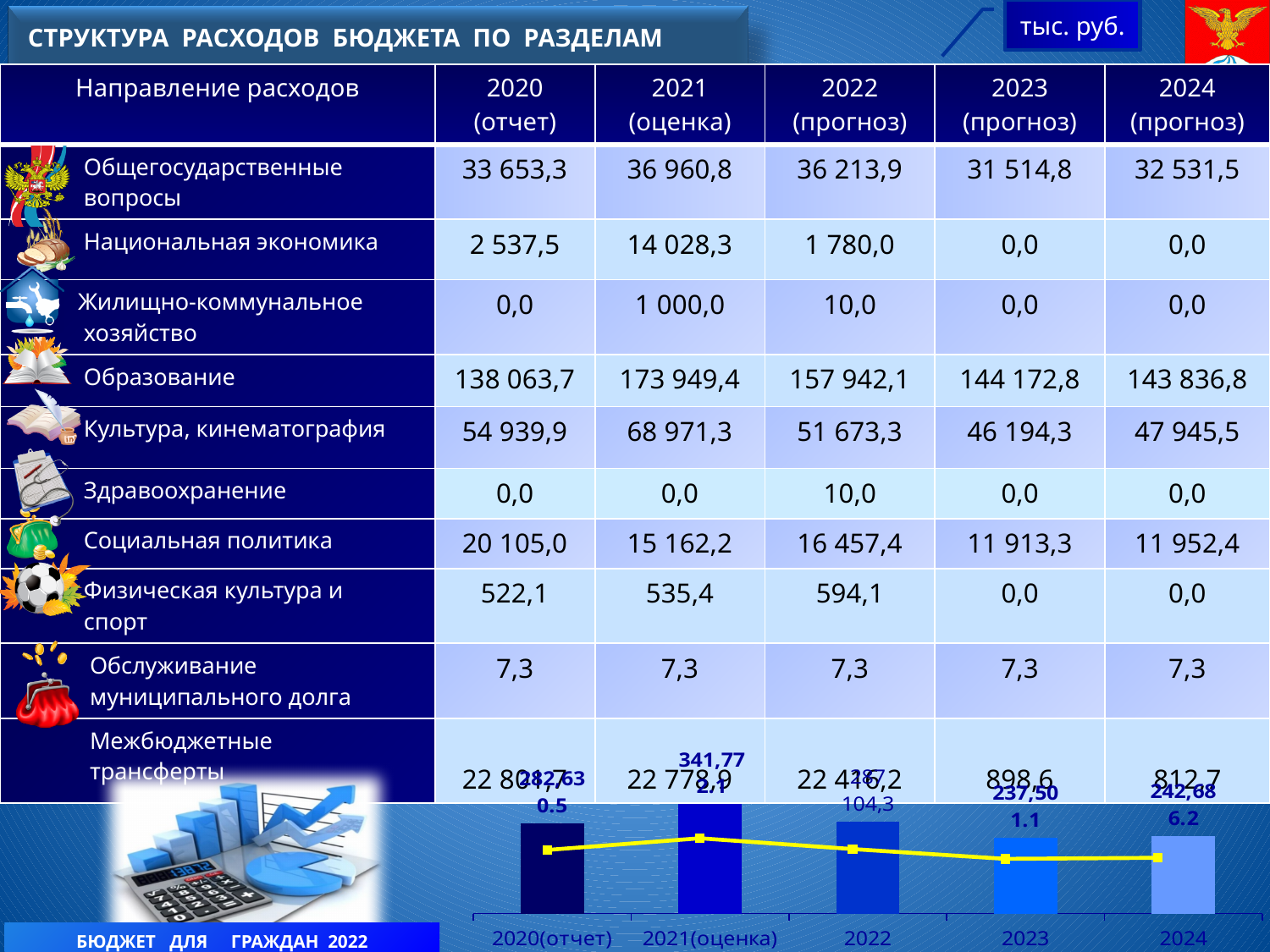
In the chart at the bottom of the slide, what is the bar value labelled for 2021(оценка)? 341,772.1 How many categories (years) are shown on the x axis of the chart at the bottom of the slide? 5 In the chart at the bottom of the slide, which year has the shortest bar? 2023 In the chart at the bottom of the slide, what is the bar value labelled for 2024? 242,686.2 In the chart at the bottom of the slide, which bar is larger: 2023 or 2024? 2024 What kind of chart is shown at the bottom of the slide? bar chart with a line In the chart at the bottom of the slide, do the bar values rise or fall from 2021(оценка) to 2023? fall In the chart at the bottom of the slide, what is the bar value labelled for 2023? 237,501.1 In the chart at the bottom of the slide, what is the difference between the bar values for 2024 and 2023? 5,185.1 In the chart at the bottom of the slide, what is the difference between the bar values for 2021(оценка) and 2023? 104,271.0 In the chart at the bottom of the slide, which year has the tallest bar? 2021(оценка)